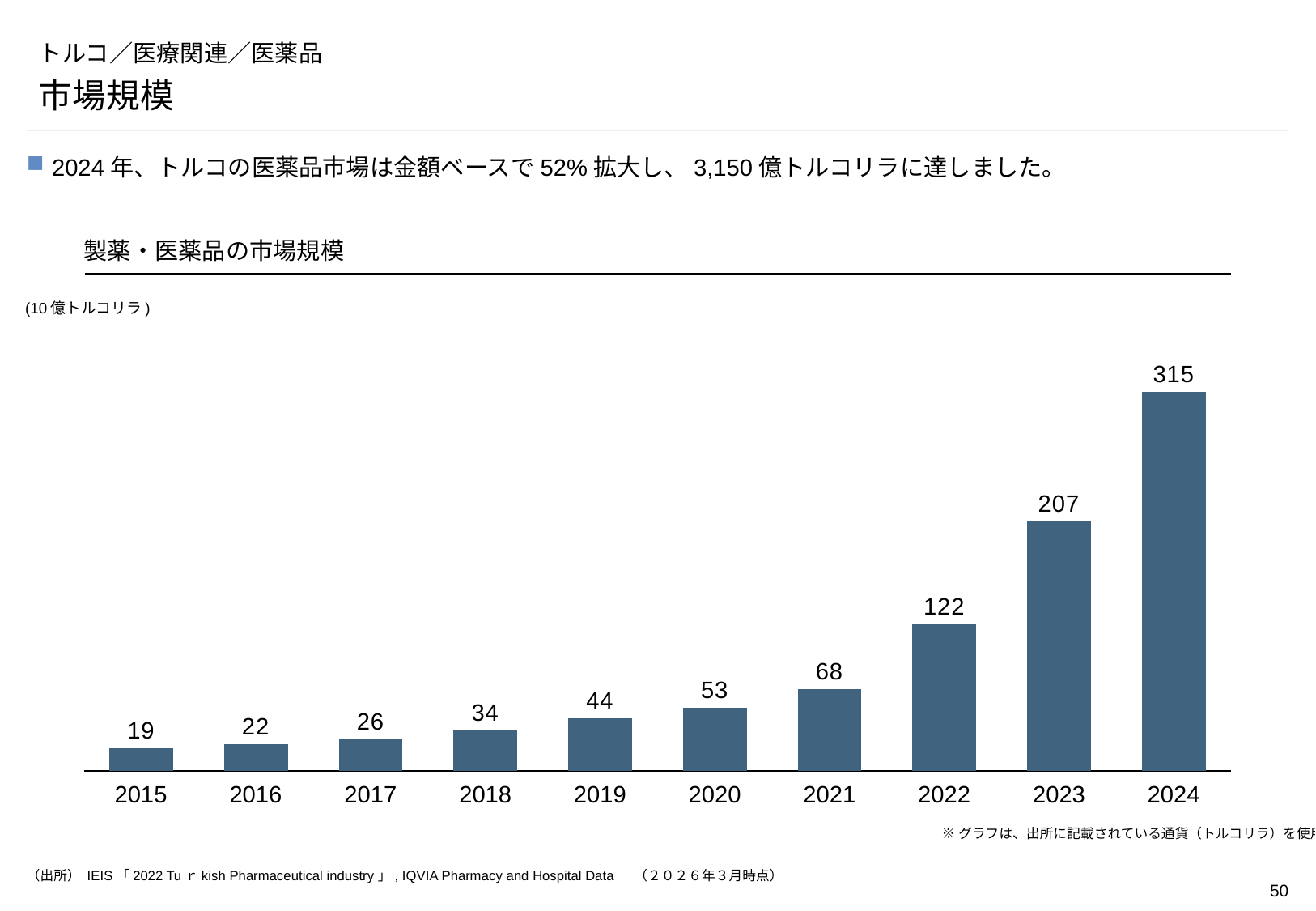
What is the value for 2019? 44 Which is larger, the value for 2020 or the value for 2018? 2020 What is the title of the chart? 製薬・医薬品の市場規模 What is the value for 2015? 19 What is the difference between the values for 2024 and 2023? 108 Which year has the highest value? 2024 How many years are shown on the x axis? 10 What kind of chart is this? bar chart Do the values rise or fall from 2015 to 2024? rise What is the difference between the values for 2022 and 2021? 54 What is the value for 2024? 315 Which year has the lowest value? 2015